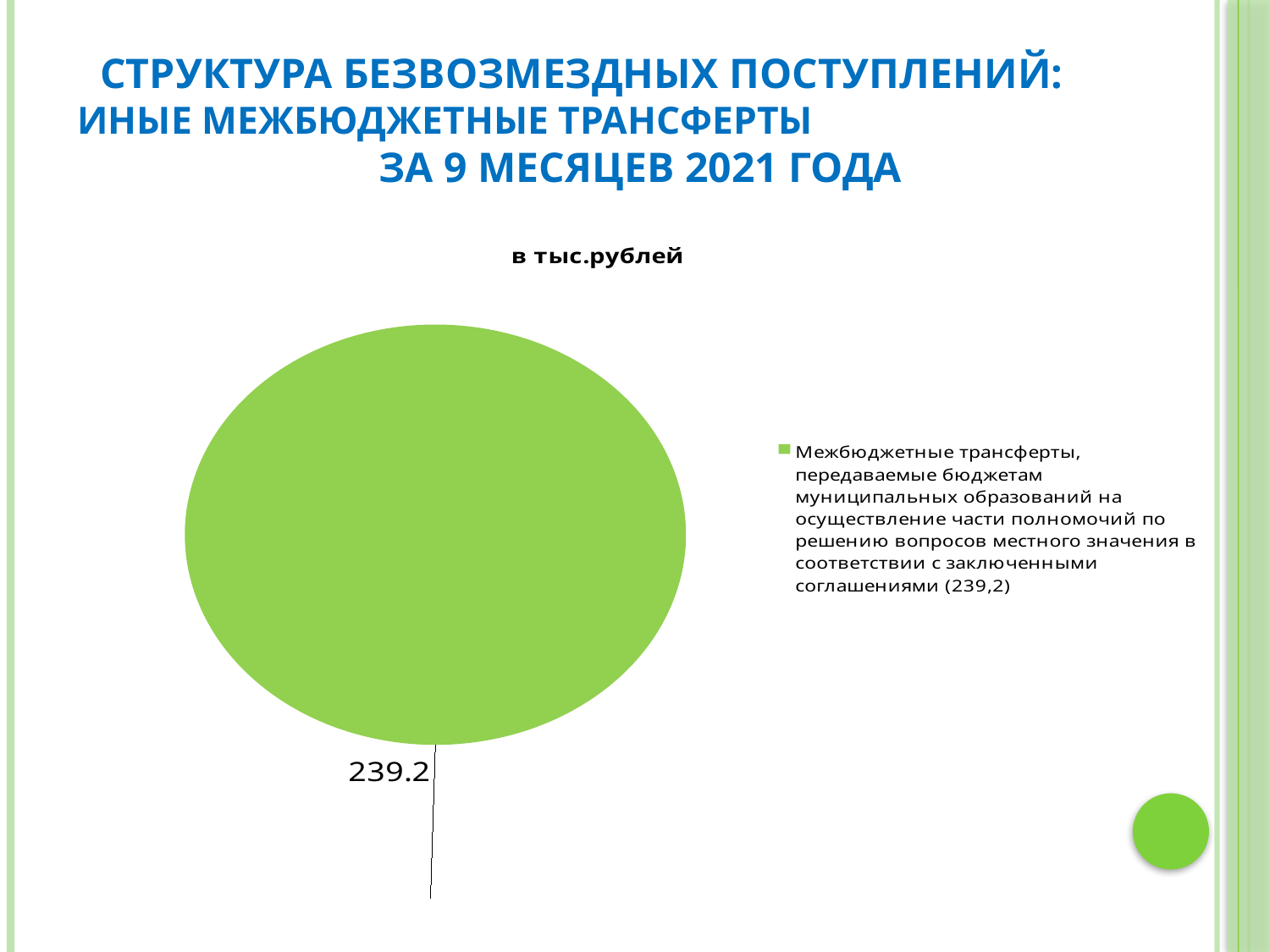
What value is shown in parentheses at the end of the legend entry? 239,2 What colour is the slice of the pie chart? green What kind of chart is shown on the slide? pie chart How many slices does the pie chart have? 1 What is the value for 'Межбюджетные трансферты, передаваемые бюджетам муниципальных образований на осуществление части полномочий по решению вопросов местного значения в соответствии с заключенными соглашениями' according to the chart? 239.2 How many entries does the legend of the pie chart list? 1 What is the title shown above the pie chart? в тыс.рублей What share of the pie does the single slice 'Межбюджетные трансферты, передаваемые бюджетам муниципальных образований...' represent? 100% What value is printed as the data label on the pie chart? 239.2